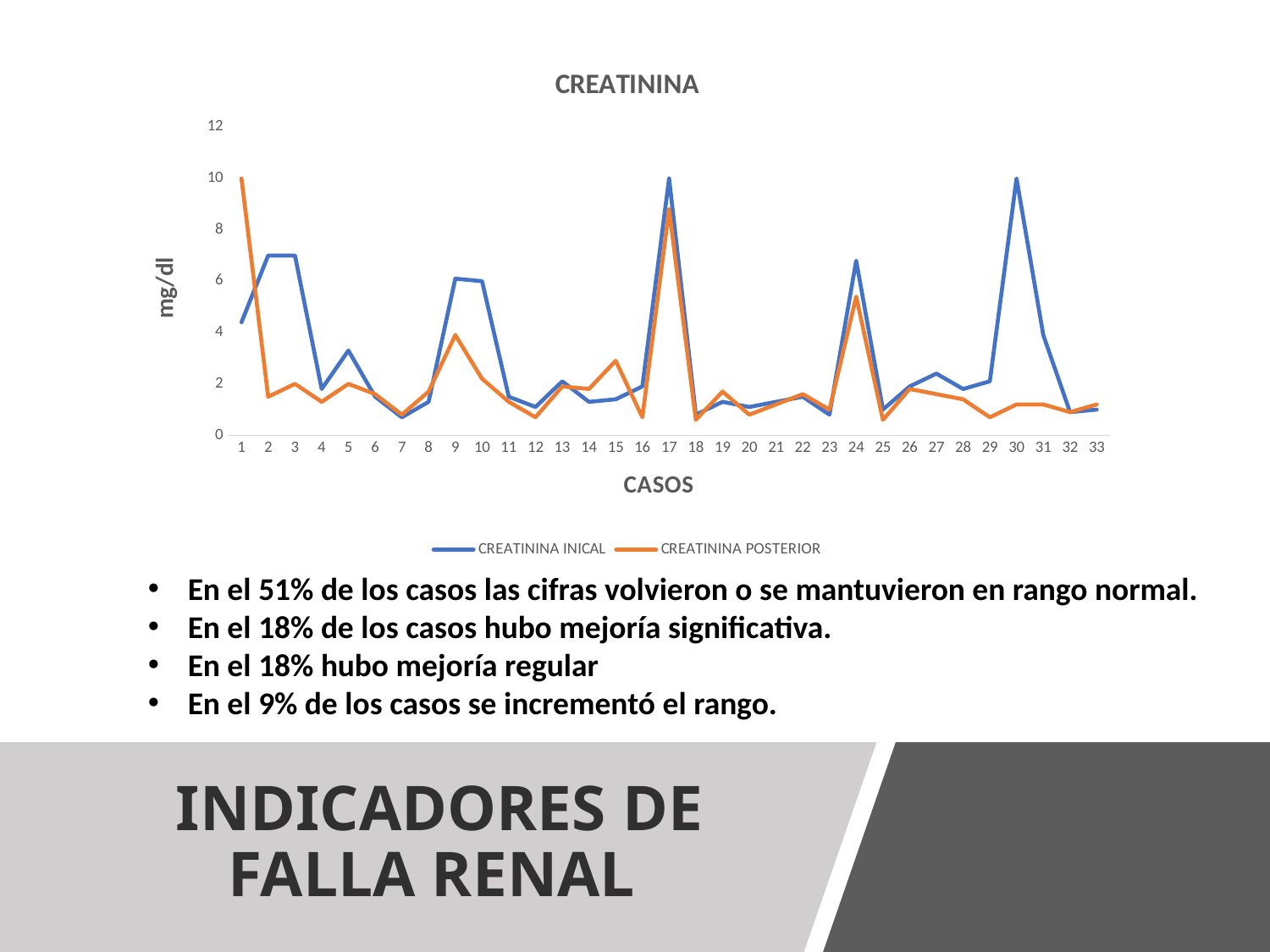
At which case does the CREATININA POSTERIOR series reach its highest value? 1 Is the CREATININA POSTERIOR value for case 2 greater or less than 4? less Is the CREATININA INICAL value for case 9 greater or less than 4? greater Is the CREATININA INICAL value for case 30 greater or less than 8? greater What is the title of the chart? CREATININA Which series has the highest value at case 1, CREATININA INICAL or CREATININA POSTERIOR? CREATININA POSTERIOR How many series does the legend of the CREATININA chart list? 2 Which series has the higher value at case 30, CREATININA INICAL or CREATININA POSTERIOR? CREATININA INICAL How many cases are plotted along the x axis of the CREATININA chart? 33 What kind of chart is shown on the slide? line chart What label is shown on the vertical axis of the chart? mg/dl Which series has the higher value at case 2, CREATININA INICAL or CREATININA POSTERIOR? CREATININA INICAL